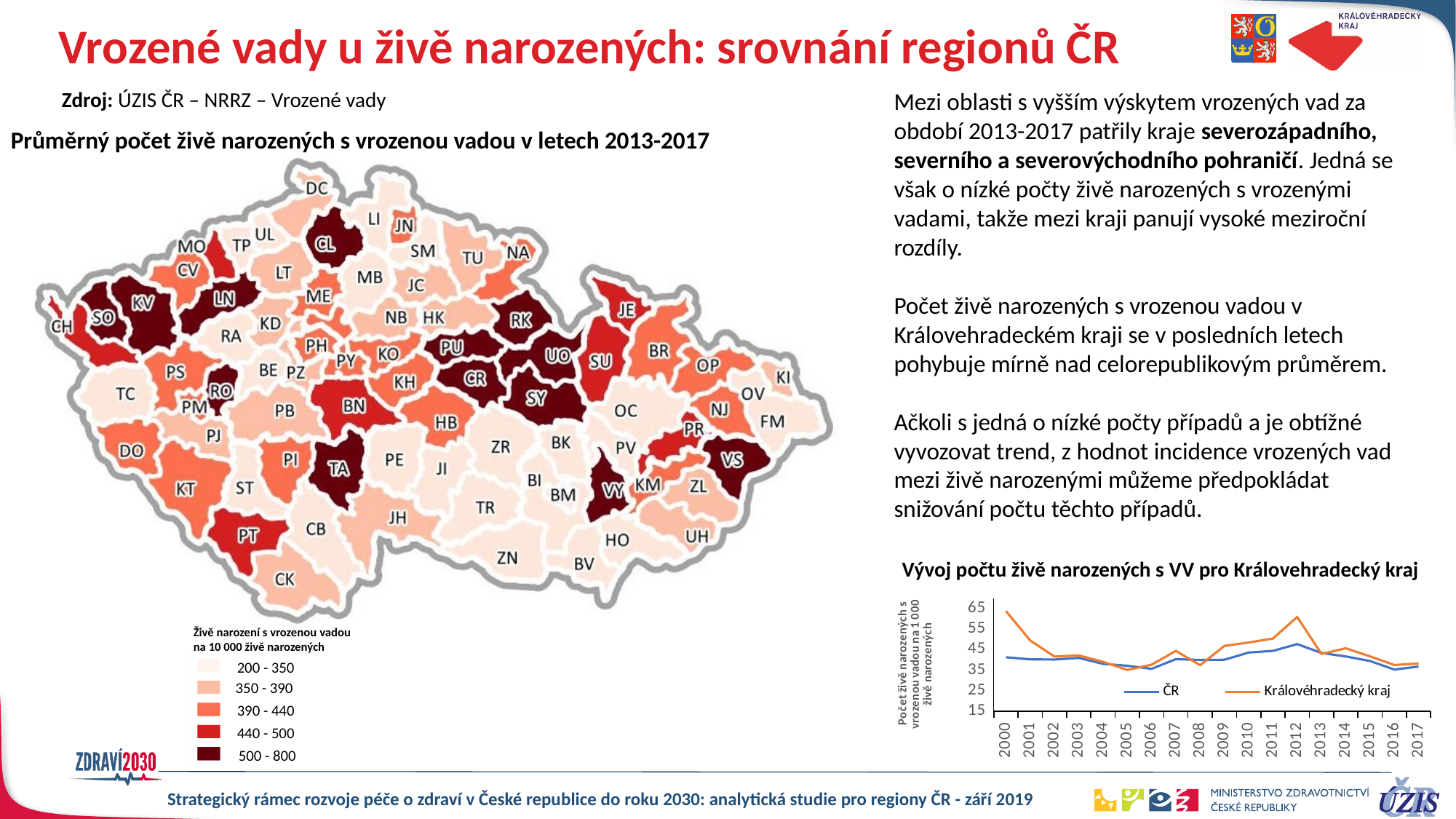
How many years are shown on the x axis of the line chart 'Vývoj počtu živě narozených s VV pro Královehradecký kraj'? 18 In the line chart 'Vývoj počtu živě narozených s VV pro Královehradecký kraj', does the Královéhradecký kraj series overall rise or fall from 2000 to 2017? fall In the line chart 'Vývoj počtu živě narozených s VV pro Královehradecký kraj', is the value for ČR in 2000 greater or less than 45? less In the line chart 'Vývoj počtu živě narozených s VV pro Královehradecký kraj', is the value for Královéhradecký kraj in 2012 greater or less than 55? greater What kind of chart is 'Vývoj počtu živě narozených s VV pro Královehradecký kraj'? line chart Which two series are shown in the legend of the line chart 'Vývoj počtu živě narozených s VV pro Královehradecký kraj'? ČR and Královéhradecký kraj In the line chart 'Vývoj počtu živě narozených s VV pro Královehradecký kraj', which series has the higher value in 2012, ČR or Královéhradecký kraj? Královéhradecký kraj In the line chart 'Vývoj počtu živě narozených s VV pro Královehradecký kraj', is the value for ČR in 2017 greater or less than 45? less In the line chart 'Vývoj počtu živě narozených s VV pro Královehradecký kraj', in which year does the Královéhradecký kraj series reach its highest value? 2000 How many series does the legend of the line chart 'Vývoj počtu živě narozených s VV pro Královehradecký kraj' list? 2 In the line chart 'Vývoj počtu živě narozených s VV pro Královehradecký kraj', which series has the higher value in 2000, ČR or Královéhradecký kraj? Královéhradecký kraj